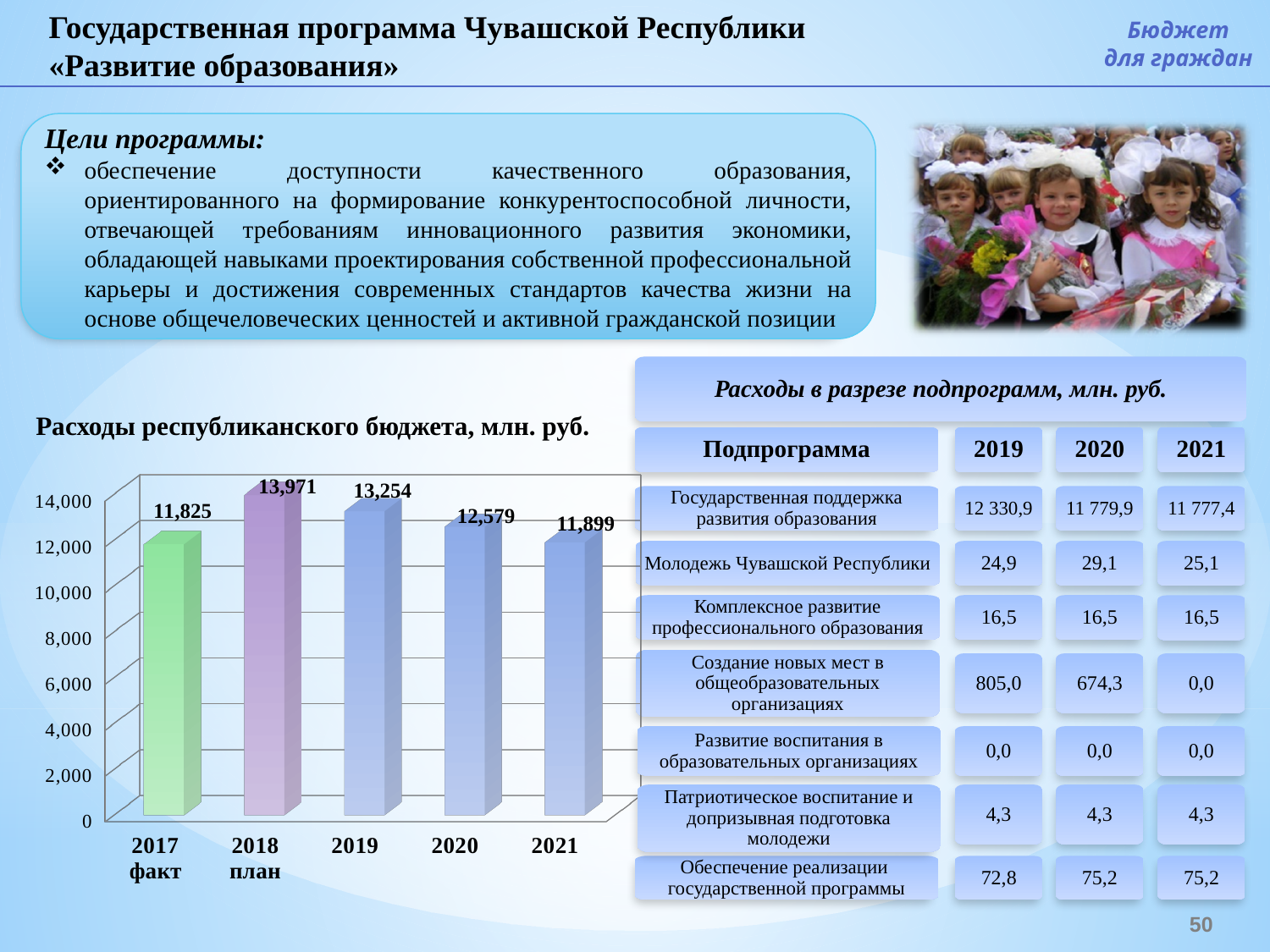
In the chart 'Расходы республиканского бюджета, млн. руб.', which is larger: the value for 2019 or the value for 2020? 2019 How many years are shown in the chart 'Расходы республиканского бюджета, млн. руб.'? 5 What is the difference between the values for 2018 and 2019 in the chart 'Расходы республиканского бюджета, млн. руб.'? 717 What is the value for 2017 in the chart 'Расходы республиканского бюджета, млн. руб.'? 11,825 What kind of chart is 'Расходы республиканского бюджета, млн. руб.'? bar chart What is the value for 2018 in the chart 'Расходы республиканского бюджета, млн. руб.'? 13,971 In the chart 'Расходы республиканского бюджета, млн. руб.', do the values rise or fall from 2018 to 2021? fall What is the difference between the values for 2020 and 2021 in the chart 'Расходы республиканского бюджета, млн. руб.'? 680 What is the value for 2021 in the chart 'Расходы республиканского бюджета, млн. руб.'? 11,899 Which year has the highest value in the chart 'Расходы республиканского бюджета, млн. руб.'? 2018 Which year has the lowest value in the chart 'Расходы республиканского бюджета, млн. руб.'? 2017 Is the value for 2020 in the chart 'Расходы республиканского бюджета, млн. руб.' greater or less than 12,000? greater